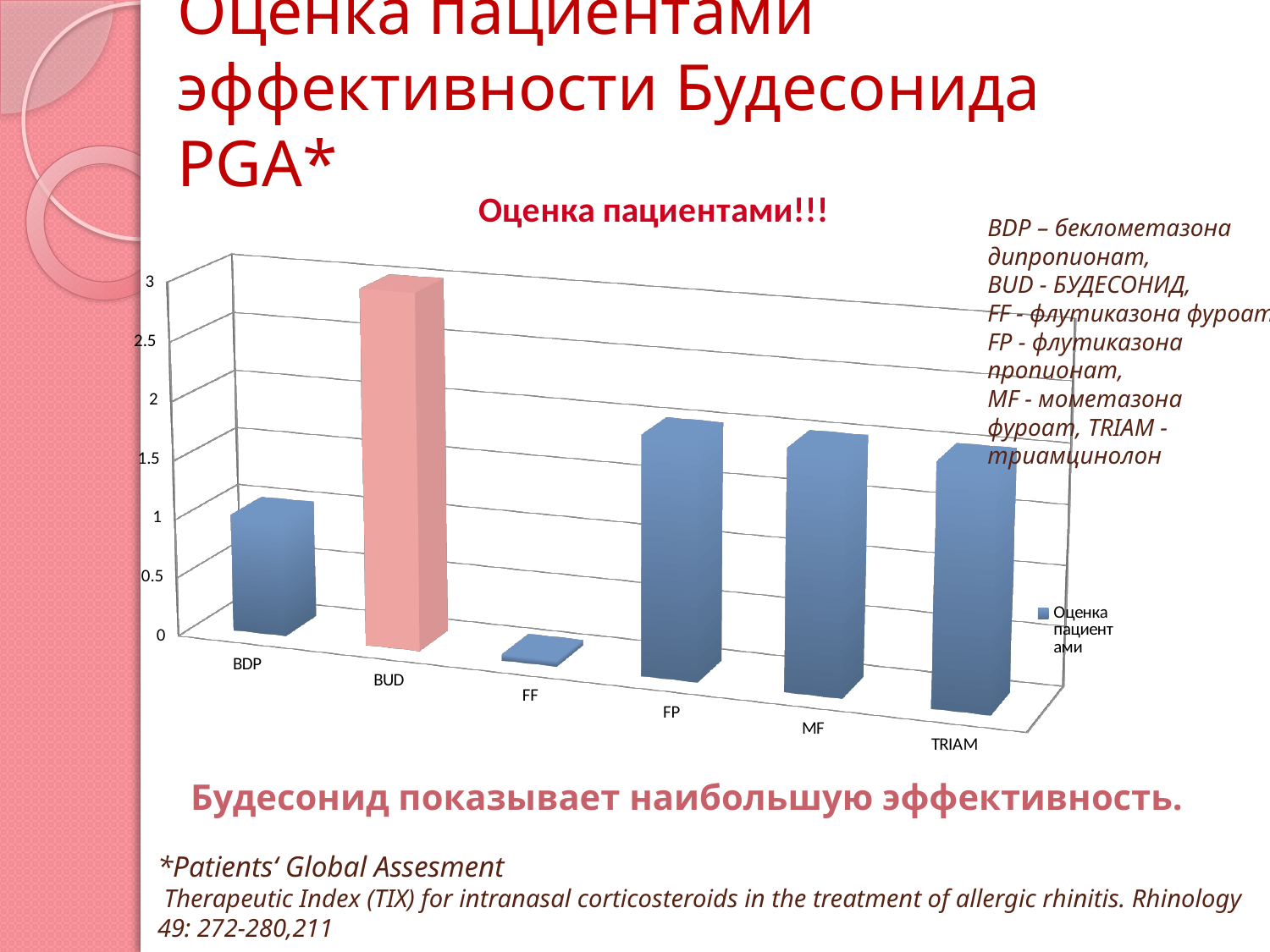
Which is larger, the value for FP or the value for FF? FP Which category has the highest bar in the chart? BUD What is the title of the chart? Оценка пациентами!!! Is the value for FF greater or less than 0.5? less Is the value for BUD greater or less than 2? greater Is the value for TRIAM greater or less than 1? greater What kind of chart is shown on the slide? bar chart How many series does the chart legend list? 1 Which category has the lowest bar in the chart? FF How many categories are plotted on the x axis of the chart? 6 Which is larger, the value for BUD or the value for BDP? BUD